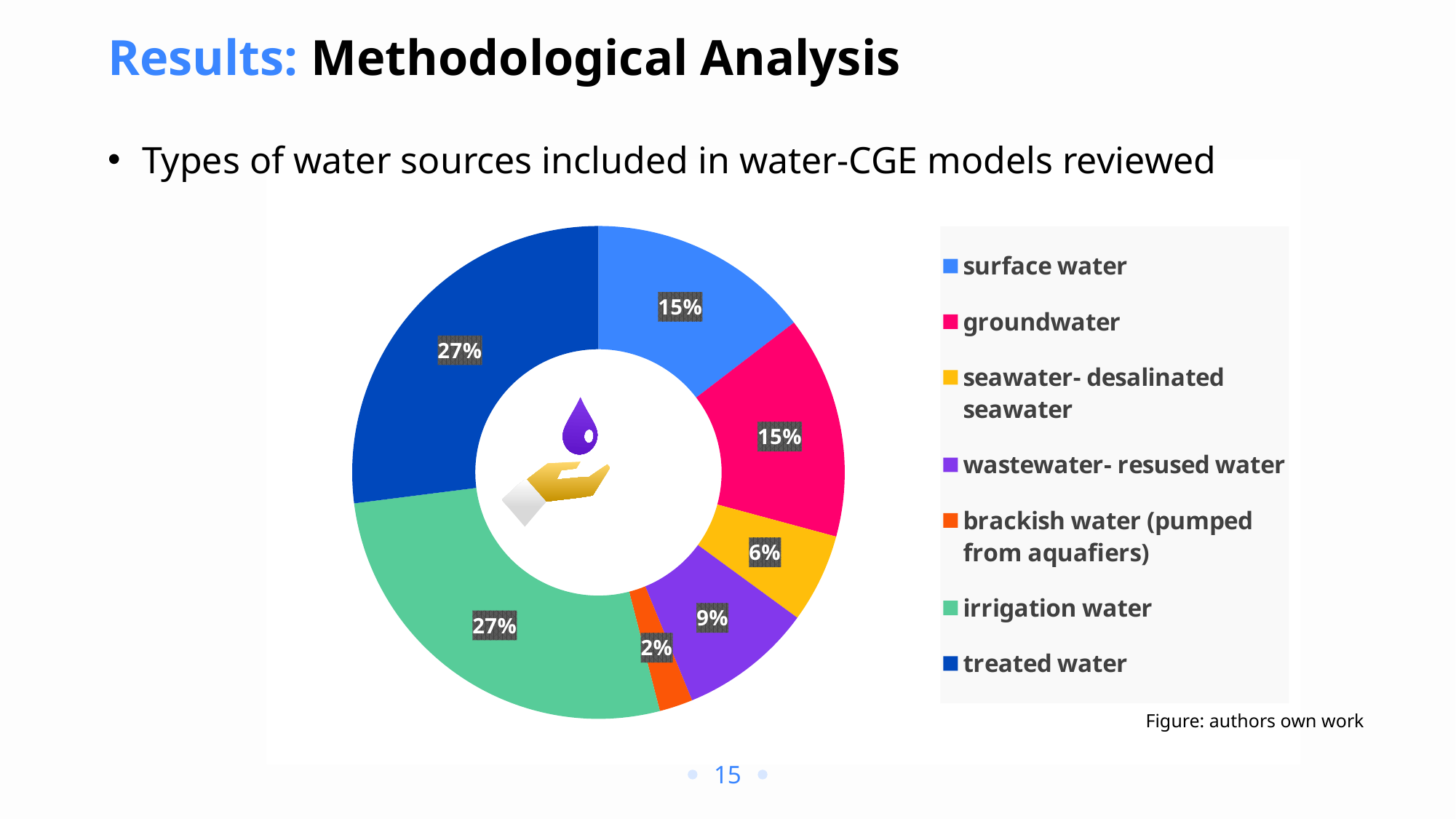
What kind of chart is shown on the slide? Pie chart (doughnut) What percentage is shown for wastewater- resused water? 9% How many water source categories does the legend list? 7 What colour represents treated water in the chart? Dark blue What share of the pie chart is surface water? 15% Which water source has the smallest share in the chart? brackish water (pumped from aquafiers) Which two water sources share the largest slice of the chart, at 27% each? irrigation water and treated water What percentage does groundwater account for in the chart? 15% What is the value for brackish water (pumped from aquafiers)? 2% What is the difference in percentage points between irrigation water and wastewater- resused water? 18 Which is larger, the share for wastewater- resused water or the share for seawater- desalinated seawater? wastewater- resused water What is the value shown for seawater- desalinated seawater? 6%